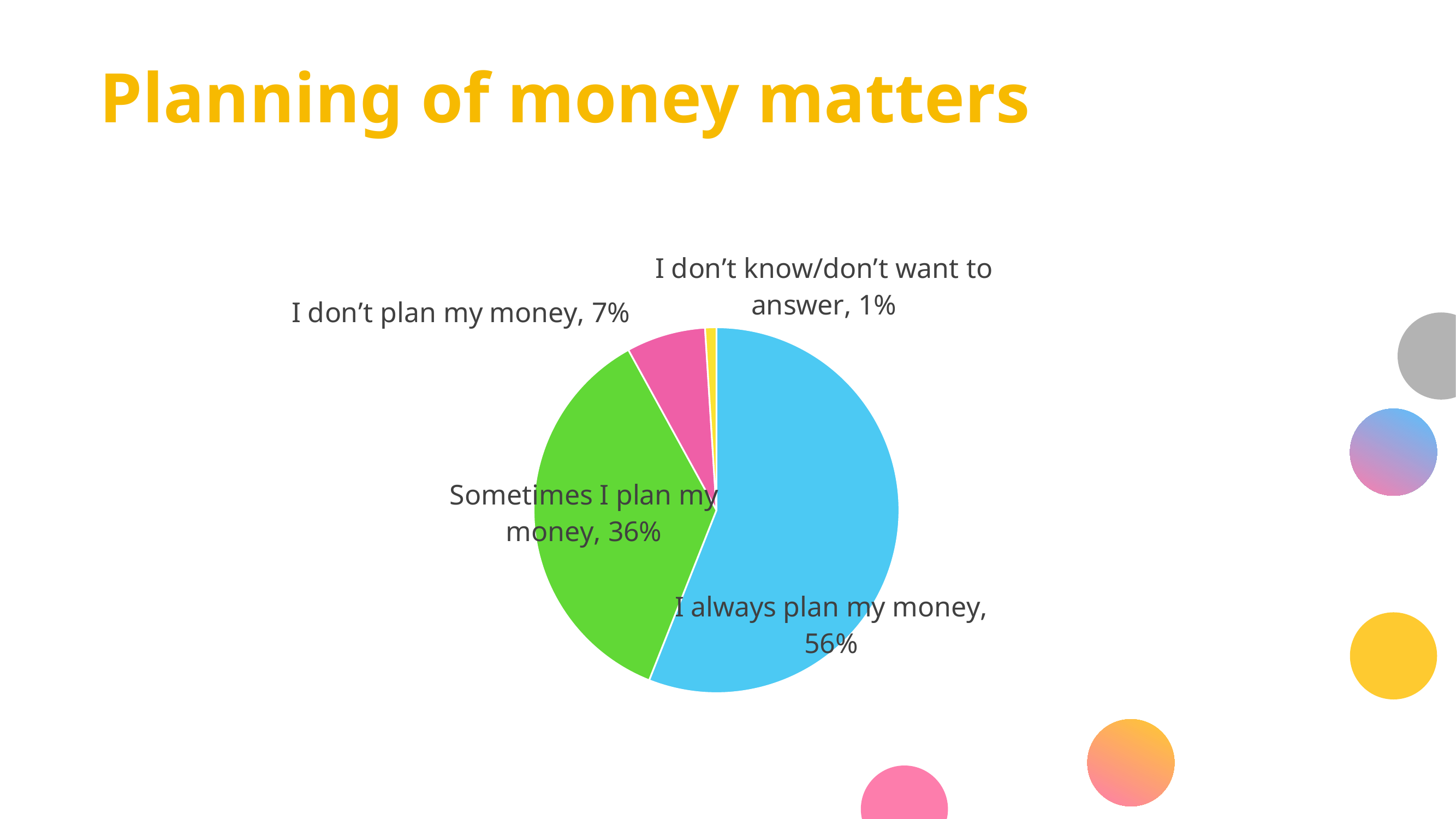
What share of respondents said "I don't know/don't want to answer"? 1% Which category has the smallest slice of the pie? I don't know/don't want to answer What share of respondents said "Sometimes I plan my money"? 36% How many slices does the pie chart have? 4 What kind of chart is shown on the slide? pie chart Which category has the largest slice of the pie? I always plan my money What colour is the slice for "Sometimes I plan my money"? green What share of respondents said "I don't plan my money"? 7% Which is larger: the share for "I don't plan my money" or the share for "I don't know/don't want to answer"? I don't plan my money What share of respondents said "I always plan my money"? 56% What is the title of the slide containing the pie chart? Planning of money matters What is the difference in percentage points between "I always plan my money" and "Sometimes I plan my money"? 20 percentage points